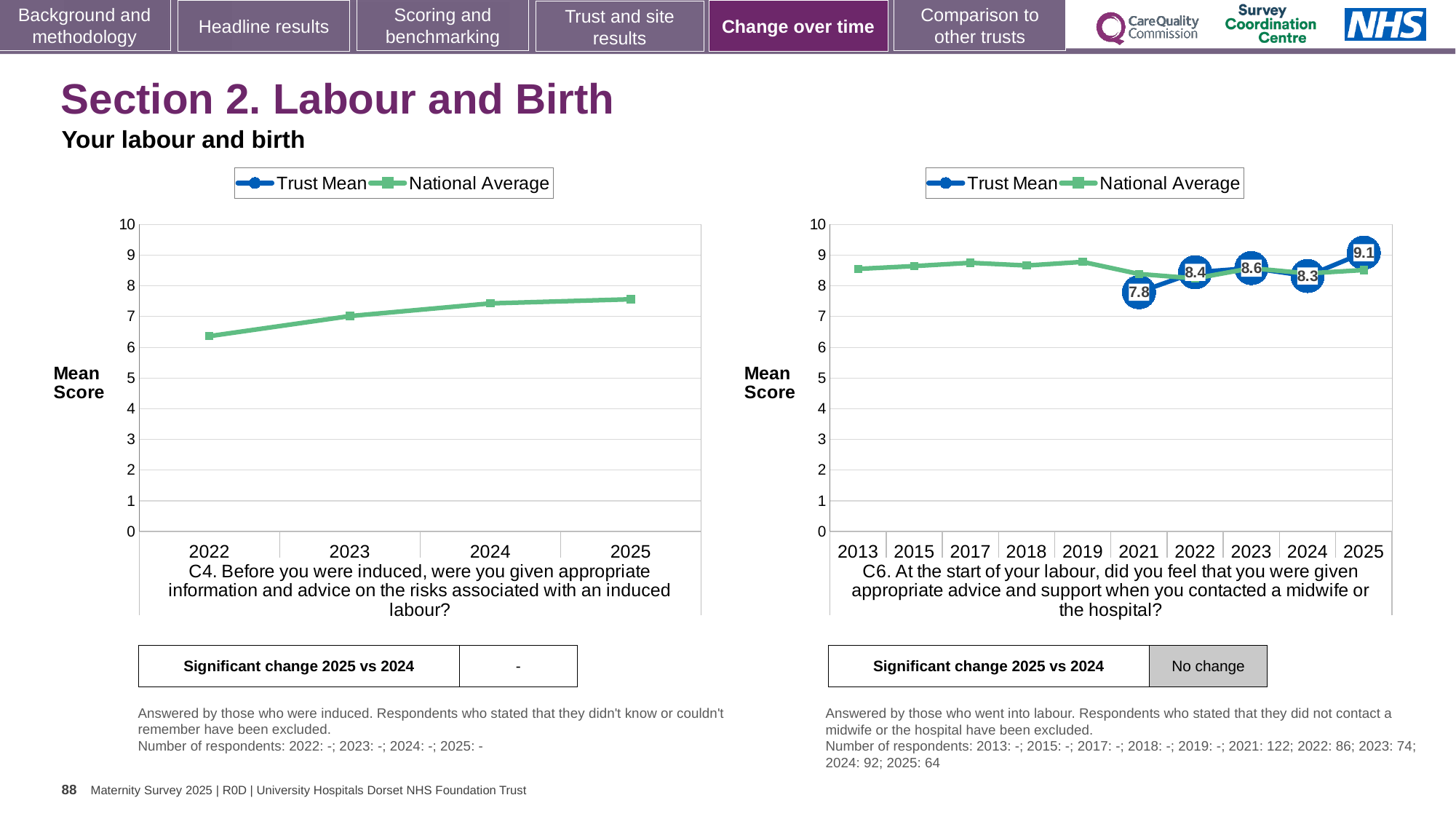
In the right chart (C6), what is the Trust Mean score for 2025? 9.1 In the right chart (C6), which year has the highest Trust Mean score? 2025 In the left chart (C4), is the National Average value for 2022 greater or less than 7? less In the left chart (C4), does the National Average rise or fall from 2022 to 2025? Rises In the right chart (C6), which year has the lowest labelled Trust Mean score? 2021 In the right chart (C6), what is the Trust Mean score for 2021? 7.8 In the right chart (C6), is the Trust Mean score higher in 2022 or 2023? 2023 How many years are shown on the x axis of the right chart (C6)? 10 In the right chart (C6), what is the Trust Mean score for 2024? 8.3 In the right chart (C6), what is the difference between the Trust Mean scores for 2025 and 2024? 0.8 How many series does the legend of the left chart (C4) list? 2 What type of chart is the left chart (C4)? Line chart